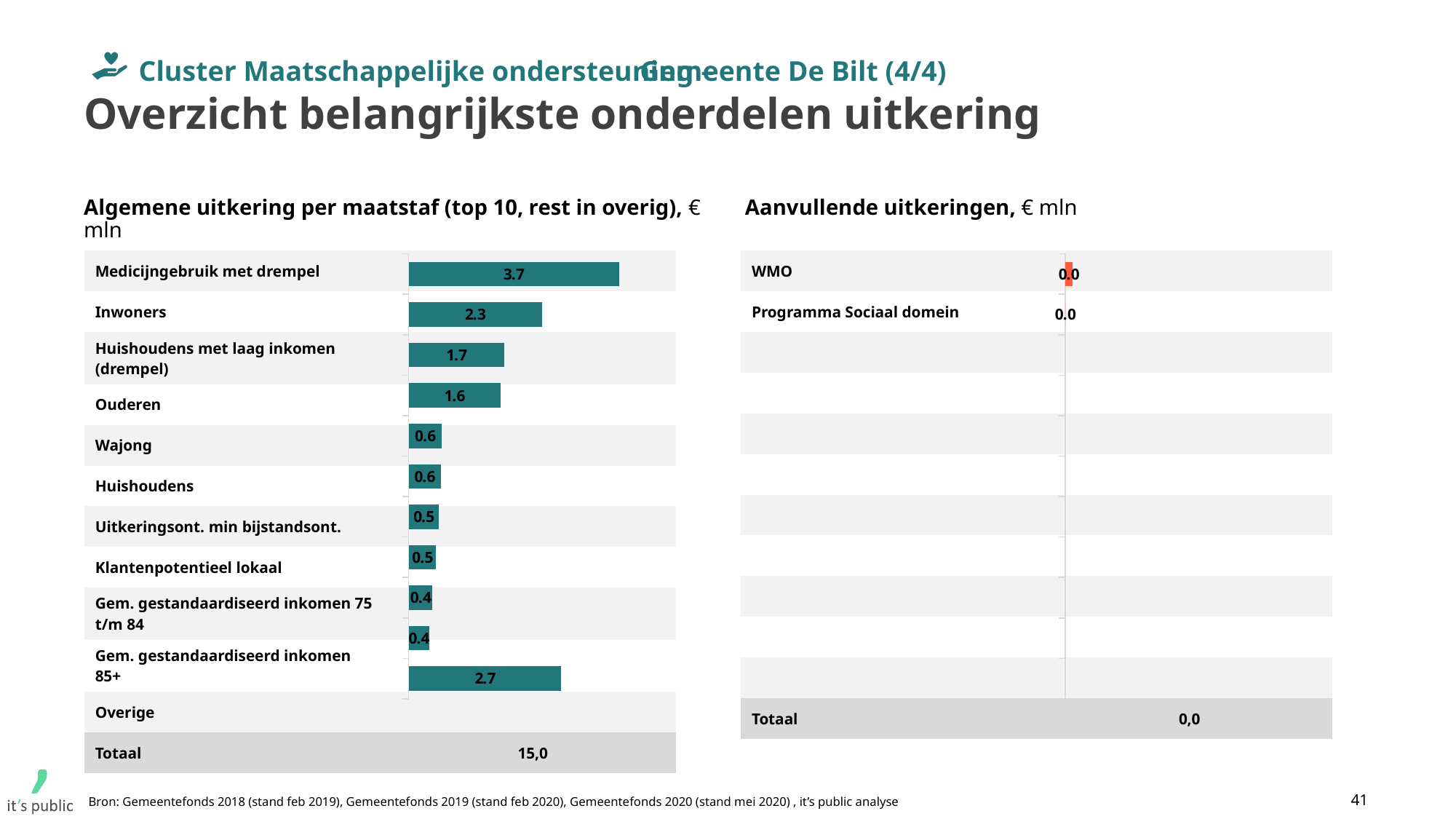
In the chart 'Algemene uitkering per maatstaf', what is the value for Overige? 2.7 In the chart 'Algemene uitkering per maatstaf', which category has the highest value? Medicijngebruik met drempel In the chart 'Algemene uitkering per maatstaf', what is the value for Medicijngebruik met drempel? 3.7 What unit is stated in the title of the chart 'Aanvullende uitkeringen'? € mln In the chart 'Aanvullende uitkeringen', what is the Totaal shown? 0,0 What kind of chart is 'Algemene uitkering per maatstaf'? Bar chart In the chart 'Algemene uitkering per maatstaf', which is larger: Ouderen or Huishoudens met laag inkomen (drempel)? Huishoudens met laag inkomen (drempel) In the chart 'Algemene uitkering per maatstaf', what is the Totaal shown? 15,0 In the chart 'Aanvullende uitkeringen', what is the value for WMO? 0.0 In the chart 'Algemene uitkering per maatstaf', what is the value for Inwoners? 2.3 In the chart 'Algemene uitkering per maatstaf', what is the difference between Medicijngebruik met drempel and Inwoners? 1.4 In the chart 'Algemene uitkering per maatstaf', how many categories are plotted as bars (excluding Totaal)? 11